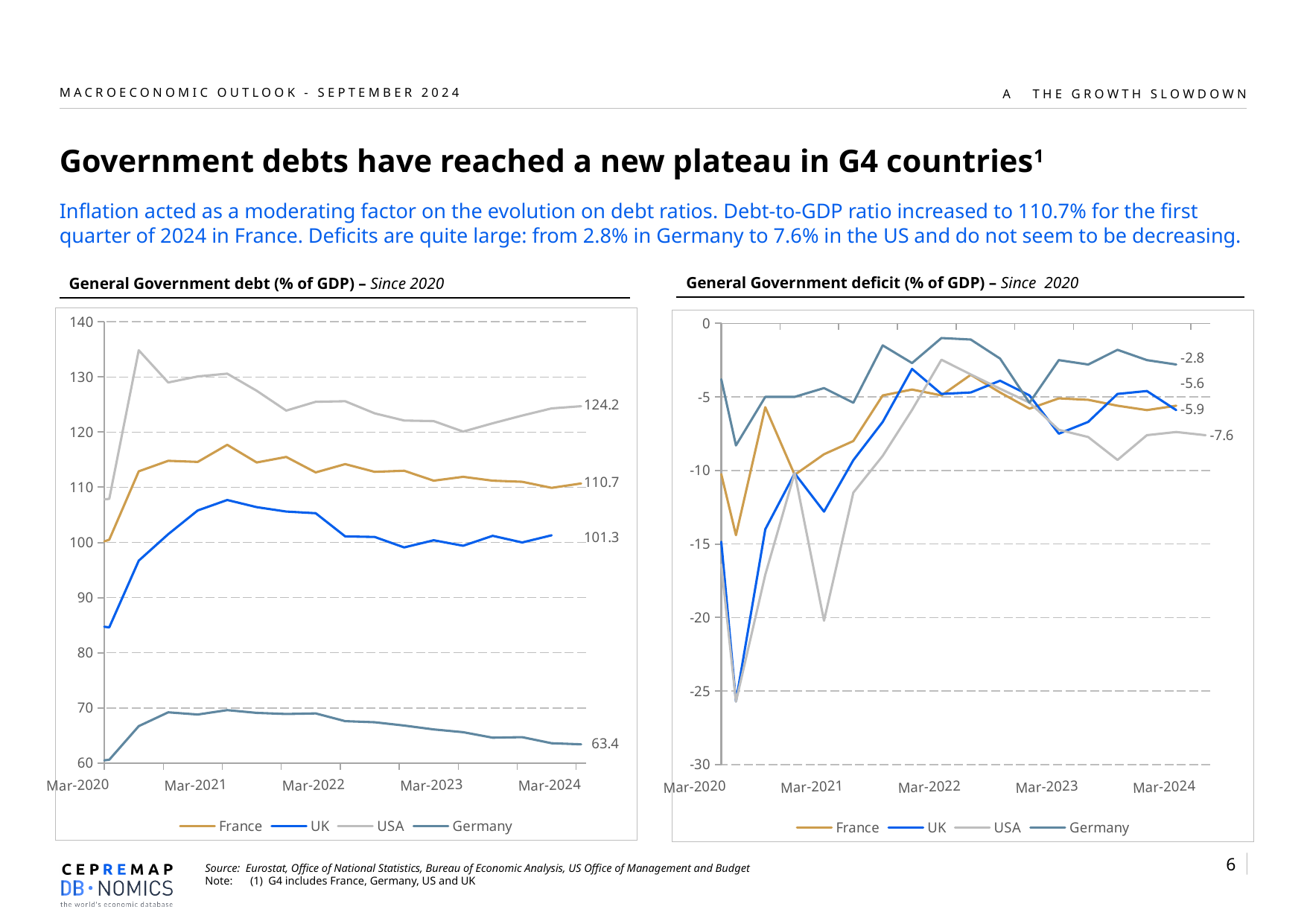
In the 'General Government debt (% of GDP)' chart, which country has the highest debt ratio at the end of the series? USA In the 'General Government debt (% of GDP)' chart, what is the latest labelled value for Germany? 63.4 How many series does the legend of the 'General Government debt (% of GDP)' chart list? 4 What kind of chart is the 'General Government debt (% of GDP)' chart on the left? line chart In the 'General Government debt (% of GDP)' chart, what is the latest labelled value for France? 110.7 In the 'General Government debt (% of GDP)' chart, is the value for Germany at Mar-2024 greater or less than 70? less In the 'General Government debt (% of GDP)' chart, which country has the lowest debt ratio at the end of the series? Germany In the 'General Government deficit (% of GDP)' chart, what is the latest labelled value for Germany? -2.8 In the 'General Government debt (% of GDP)' chart, what is the difference between the latest labelled values for the USA and France? 13.5 In the 'General Government debt (% of GDP)' chart, what is the latest labelled value for the UK? 101.3 In the 'General Government debt (% of GDP)' chart, what is the latest labelled value for the USA? 124.2 In the 'General Government deficit (% of GDP)' chart, what is the latest labelled value for the USA? -7.6